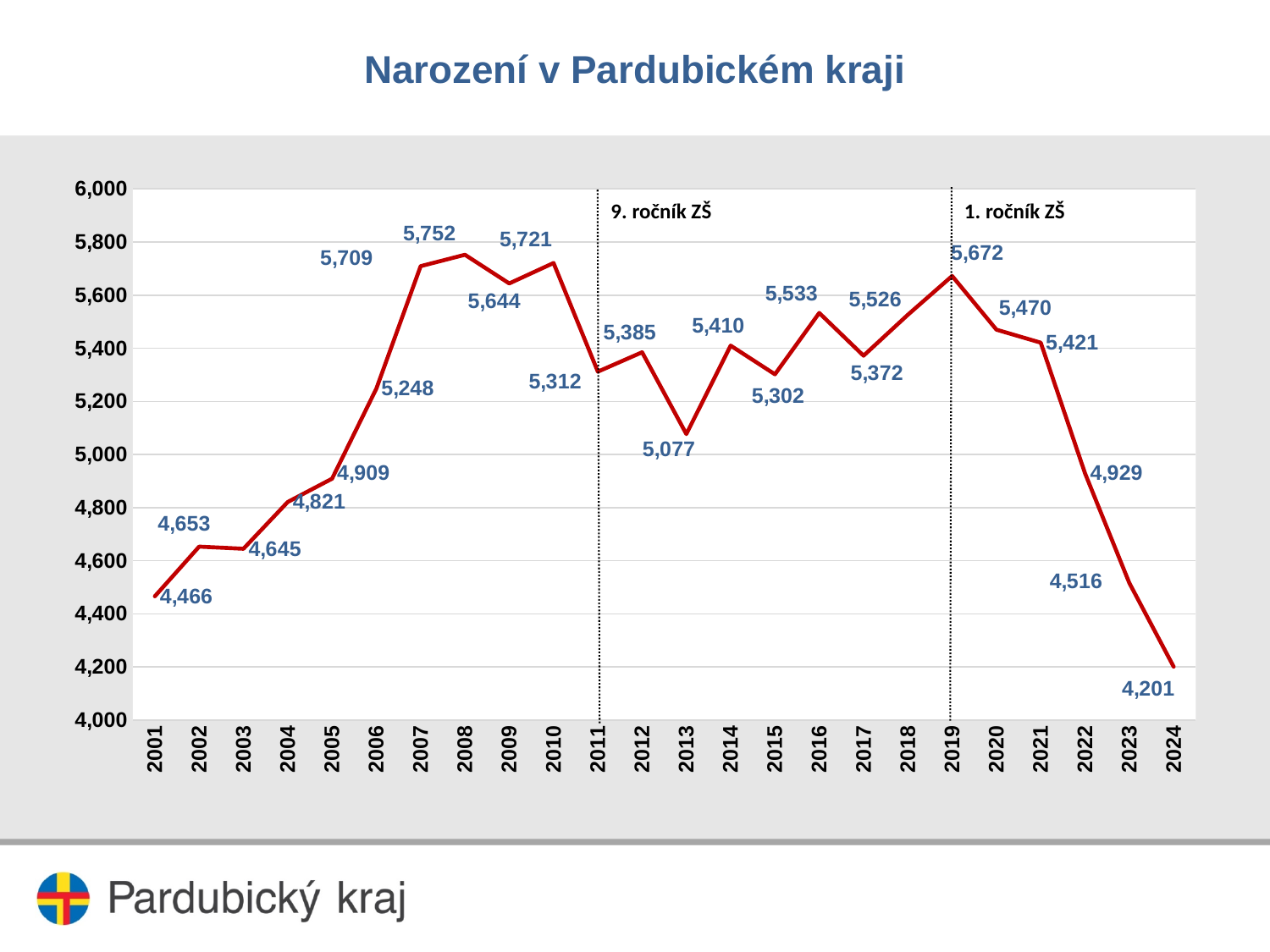
Which year has the highest value? 2008 What is the title of the chart? Narození v Pardubickém kraji What type of chart is shown on the slide? Line chart Which year has the lowest value? 2024 What is the value for 2024? 4,201 How many years are plotted on the x axis? 24 Which is larger, the value for 2016 or the value for 2017? 2016 What is the value for 2008? 5,752 What is the value for 2013? 5,077 Do the values rise or fall from 2019 to 2024? Fall What is the difference between the values for 2019 and 2020? 202 What is the difference between the values for 2008 and 2024? 1,551